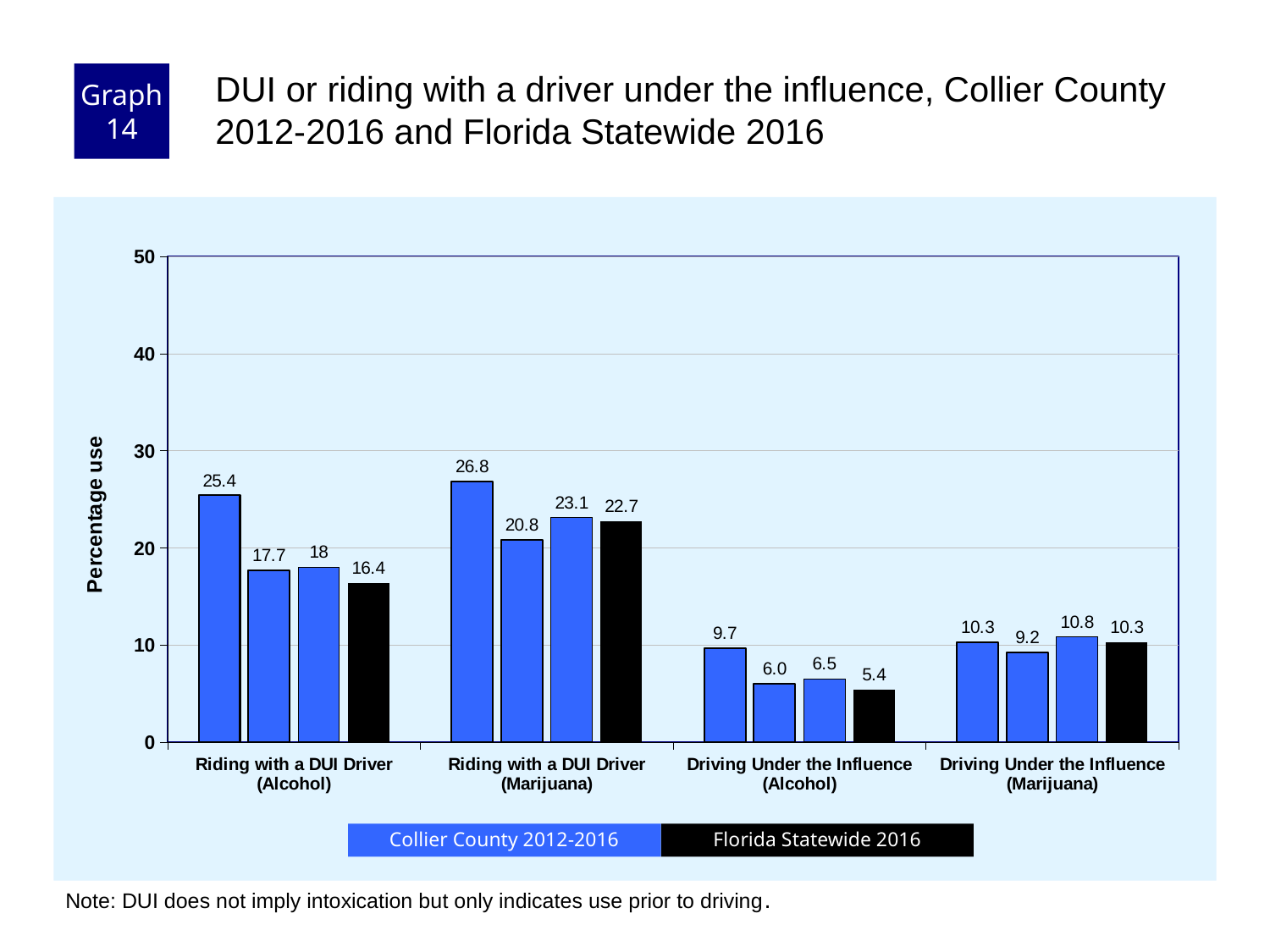
How many categories are shown on the x axis? 4 Which has a larger Florida Statewide 2016 value: Riding with a DUI Driver (Alcohol) or Riding with a DUI Driver (Marijuana)? Riding with a DUI Driver (Marijuana) What is the Florida Statewide 2016 value for Riding with a DUI Driver (Alcohol)? 16.4 What kind of chart is shown on the slide? bar chart How many series does the legend list? 2 Is the Florida Statewide 2016 value for Driving Under the Influence (Alcohol) greater or less than 10? less Which category contains the tallest bar on the chart? Riding with a DUI Driver (Marijuana) What is the lowest value shown on the chart? 5.4 What is the difference between the leftmost bar (25.4) and the Florida Statewide 2016 bar in the Riding with a DUI Driver (Alcohol) group? 9 What is the difference between the Florida Statewide 2016 values for Riding with a DUI Driver (Marijuana) and Driving Under the Influence (Marijuana)? 12.4 What is the value of the leftmost bar in the Driving Under the Influence (Alcohol) group? 9.7 What is the Florida Statewide 2016 value for Driving Under the Influence (Marijuana)? 10.3